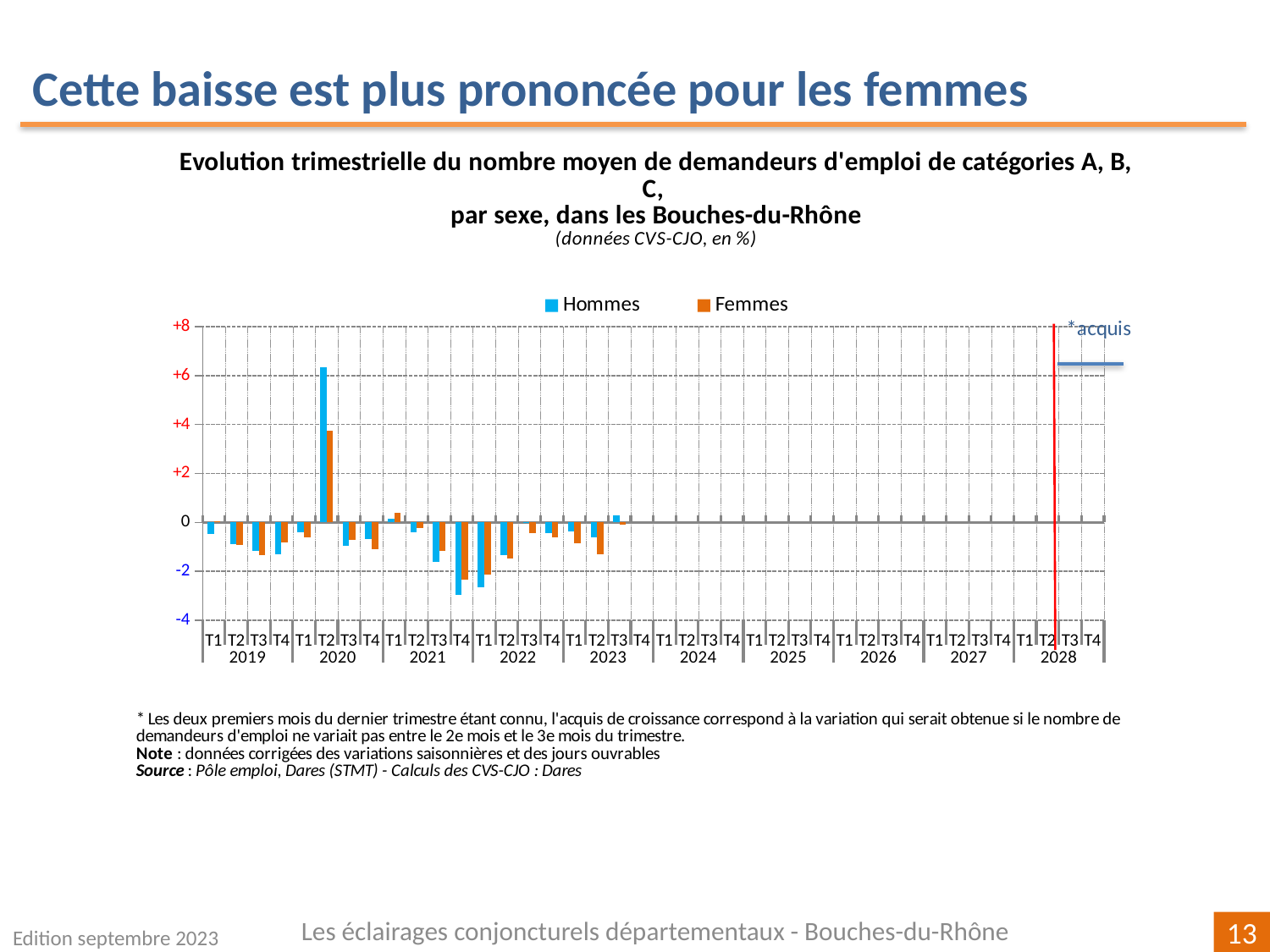
In T2 2020, which series has the larger value, Hommes or Femmes? Hommes Is the Hommes value for T4 2021 greater or less than -2? less How many years are labelled along the x axis? 10 In which quarter does the Femmes series reach its highest value? T2 2020 Which colour represents the Femmes series? orange How many series does the legend list? 2 What are the two series named in the legend? Hommes and Femmes Is the Femmes value for T2 2020 greater or less than +2? greater What kind of chart is shown on the slide? bar chart In which quarter does the Hommes series reach its lowest value? T4 2021 In which quarter does the Hommes series reach its highest value? T2 2020 Is the Hommes value for T2 2020 greater or less than +4? greater